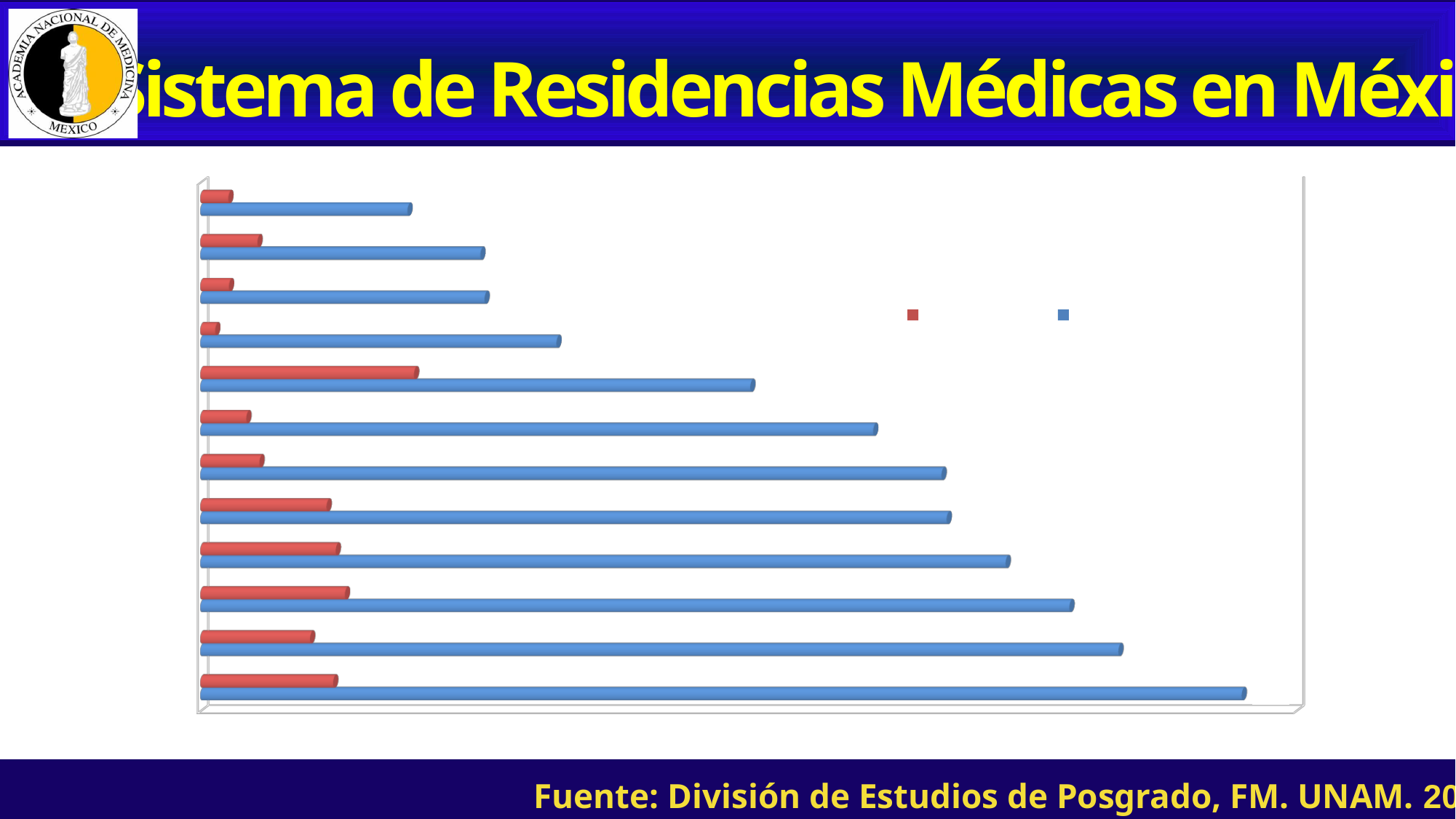
Is the longest blue bar at the top or the bottom of the chart? the bottom Is the shortest blue bar at the top or the bottom of the chart? the top How many series does the chart's legend show? 2 What two colours are used for the bar series in the chart? red and blue How many groups of bars (categories) are plotted in the chart? 12 Do the blue bars get longer or shorter moving from the top of the chart to the bottom? longer Are the bars in the chart drawn horizontally or vertically? horizontally What kind of chart is shown on the slide? bar chart Which series has the longer bars in every category, the red series or the blue series? the blue series